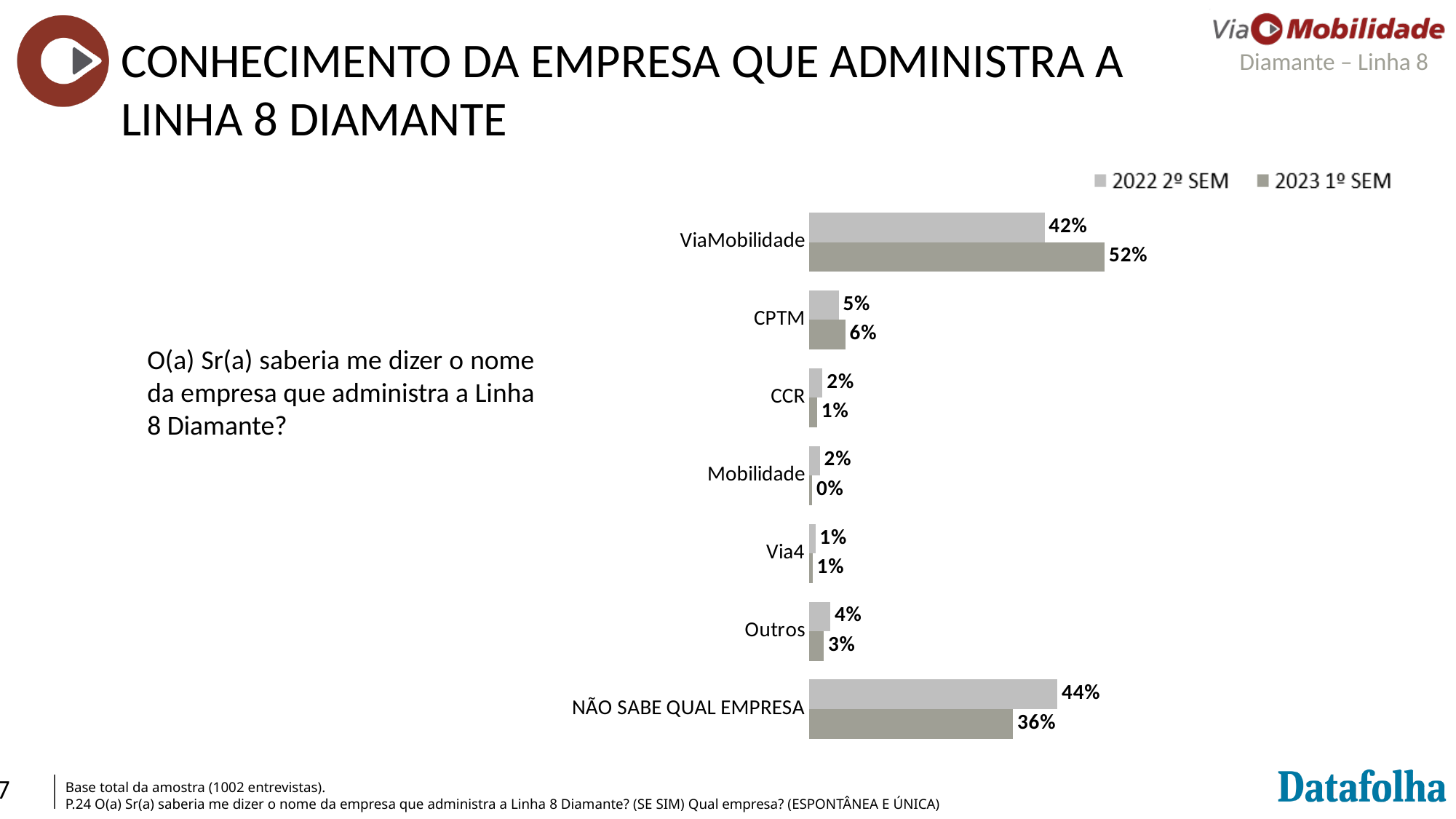
What is the value for ViaMobilidade in the 2023 1º SEM series? 52% What is the difference between the 2023 1º SEM and 2022 2º SEM values for ViaMobilidade? 10% How many series does the legend list? 2 Which is larger for Outros: the 2022 2º SEM value or the 2023 1º SEM value? 2022 2º SEM Which category has the highest value in the 2023 1º SEM series? ViaMobilidade What is the value for Mobilidade in the 2023 1º SEM series? 0% What kind of chart is shown on the slide? Bar chart What is the value for NÃO SABE QUAL EMPRESA in the 2022 2º SEM series? 44% How many categories are shown on the chart? 7 What is the value for CPTM in the 2023 1º SEM series? 6% What is the difference between the 2022 2º SEM and 2023 1º SEM values for NÃO SABE QUAL EMPRESA? 8% Which category has the highest value in the 2022 2º SEM series? NÃO SABE QUAL EMPRESA